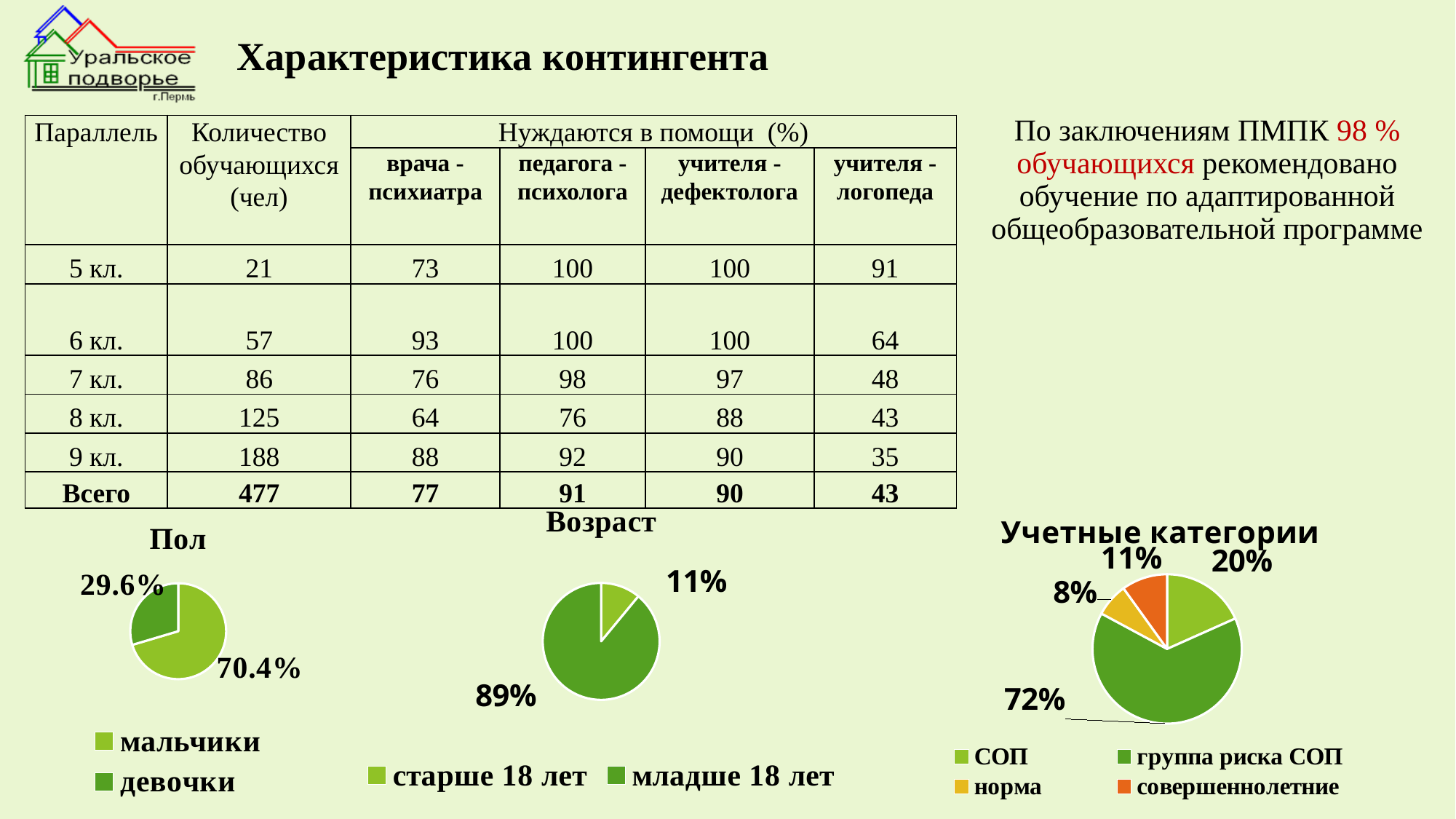
In the "Пол" pie chart, what share is labelled for девочки? 29.6% In the "Возраст" pie chart, how many series does the legend list? 2 In the "Учетные категории" pie chart, how many categories does the legend list? 4 In the "Учетные категории" pie chart, which category has the smallest share? норма In the "Пол" pie chart, which category has the larger share? мальчики In the "Пол" pie chart, what share is labelled for мальчики? 70.4% In the "Возраст" pie chart, what share is labelled for младше 18 лет? 89% In the "Возраст" pie chart, what share is labelled for старше 18 лет? 11% What type of chart is the "Учетные категории" chart? pie chart In the "Учетные категории" pie chart, what share is labelled for группа риска СОП? 72% In the "Пол" pie chart, what is the difference between the shares of мальчики and девочки? 40.8% In the "Учетные категории" pie chart, what share is labelled for норма? 8%